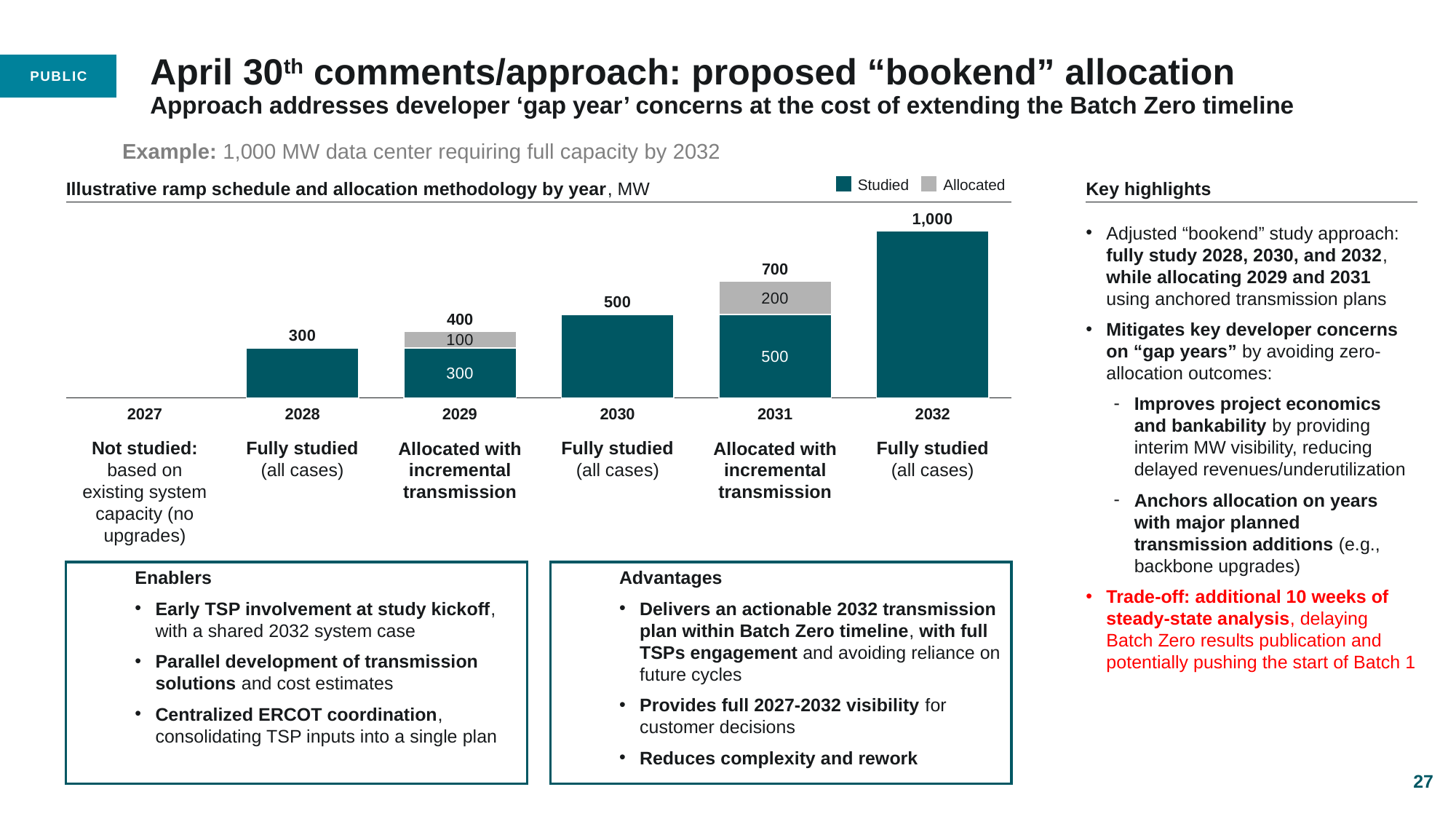
Which series in the legend is shown in grey? Allocated Do the total MW values rise or fall from 2028 to 2032? Rise What is the Studied value for 2029? 300 What is the total value shown for 2032 in the ramp schedule chart? 1,000 What is the Allocated value for 2031? 200 How many series does the chart legend list? 2 What kind of chart is used to show the illustrative ramp schedule? Stacked bar chart What is the difference between the total for 2031 and the total for 2030? 200 Which is larger, the total for 2028 or the total for 2030? 2030 Which year has the highest total MW in the chart? 2032 What is the total value labelled above the 2029 bar? 400 How many years are shown on the x axis of the chart? 6